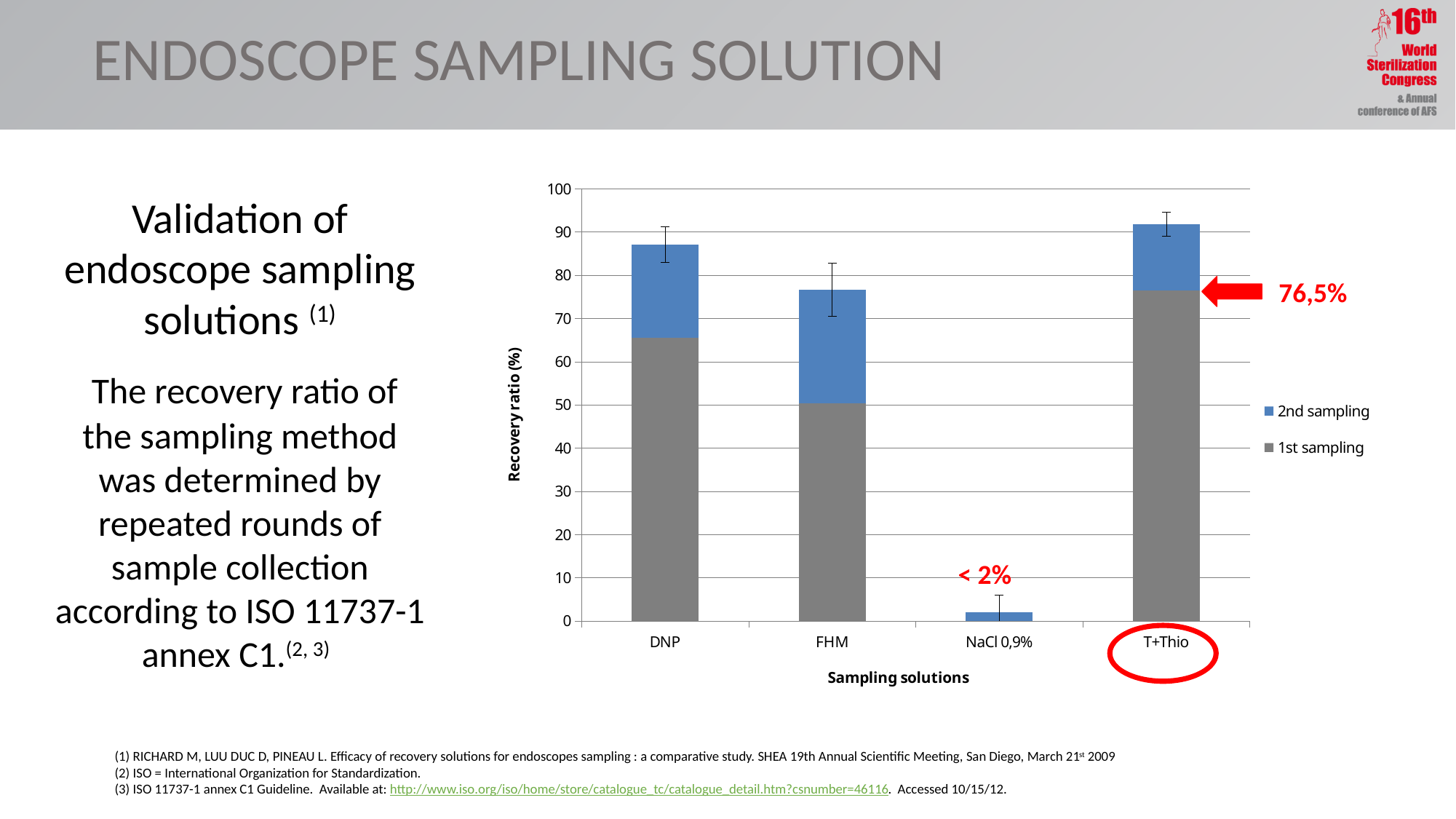
Which sampling solution has the lowest total recovery ratio? NaCl 0,9% How many sampling solutions are shown on the x axis of the chart? 4 Is the total recovery ratio for DNP greater or less than 80? greater Which sampling solution has the highest total recovery ratio? T+Thio Which series is shown in blue in the chart? 2nd sampling Is the total recovery ratio for T+Thio greater or less than 90? greater What is the title of the vertical axis of the chart? Recovery ratio (%) Which has the larger total recovery ratio, DNP or FHM? DNP Is the total recovery ratio for NaCl 0,9% greater or less than 10? less What 1st sampling recovery ratio is annotated for T+Thio? 76,5% What kind of chart is shown on the slide? Stacked bar chart How many series does the chart legend list? 2